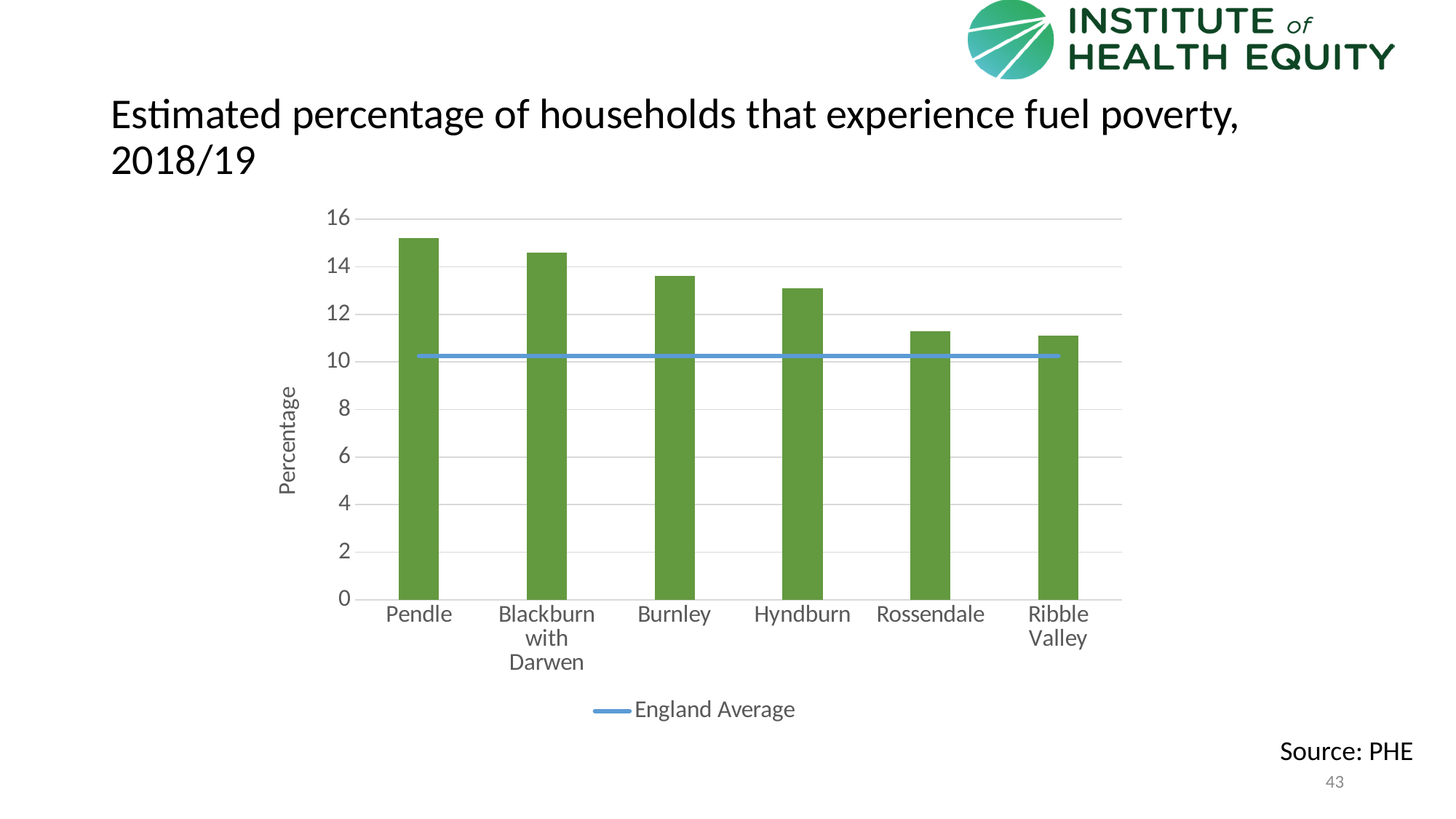
Which has a higher value, Blackburn with Darwen or Hyndburn? Blackburn with Darwen Do the bar values rise or fall moving from left to right along the x axis? fall What kind of chart is shown on the slide? bar chart What entry does the chart legend list? England Average Is the England Average line greater or less than 12? less Which area has the highest estimated percentage of households in fuel poverty? Pendle Is the value for Burnley greater or less than 14? less Is the value for Hyndburn greater or less than 12? greater What is the label on the y axis of the chart? Percentage How many local authority areas are shown on the x axis of the chart? 6